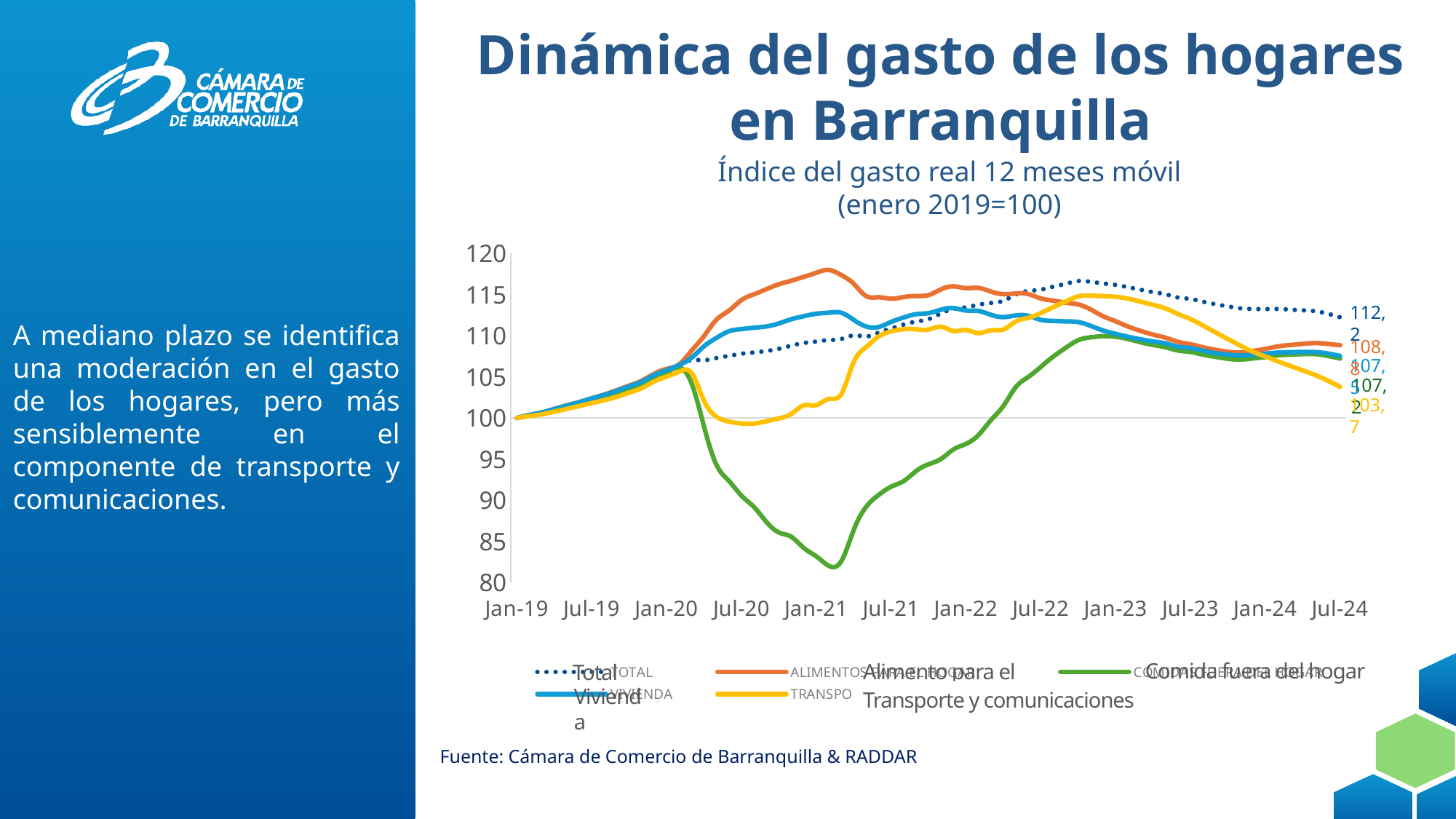
Which series has the lowest value at the right end of the chart (Jul-24)? Transporte y comunicaciones Which series drops the lowest during 2020-2021? Comida fuera del hogar Is the value of Alimento para el hogar around Jan-21 greater or less than 115? greater What kind of chart is shown on the slide? line chart What is the final value shown for the Total series at the right end of the chart? 112,2 Is the lowest point of the Comida fuera del hogar series greater or less than 85? less What is the difference between the final values of Total (112,2) and Transporte y comunicaciones (103,7)? 8,5 How many series does the legend list? 5 What is the final value shown for Transporte y comunicaciones at the right end of the chart? 103,7 Which series has the highest value at the right end of the chart (Jul-24)? Total What base period does the index use, according to the chart subtitle? enero 2019=100 Does the Transporte y comunicaciones series rise or fall between Jan-23 and Jul-24? fall